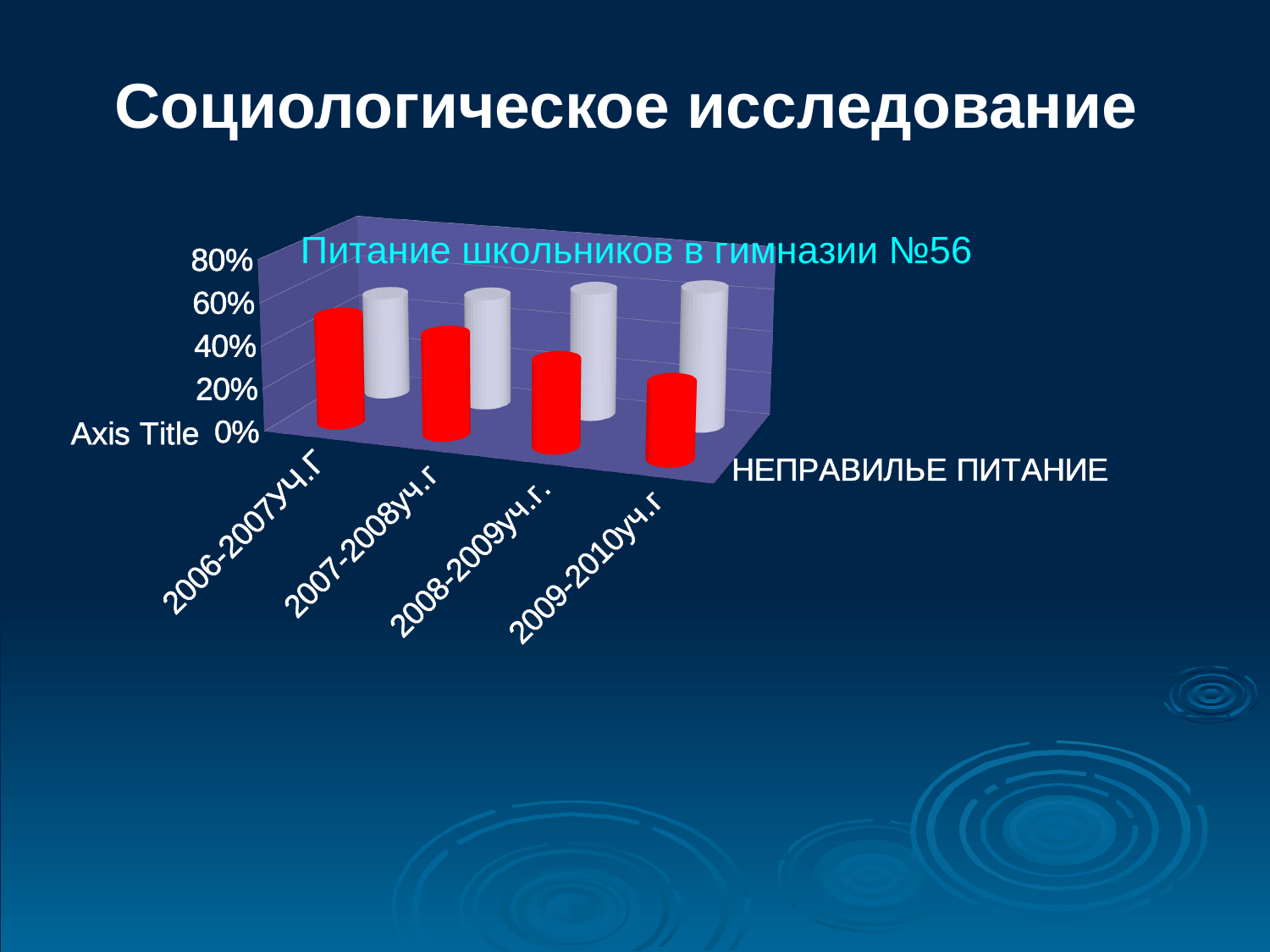
How many school-year categories are shown on the x axis of the chart? 4 Which school year has the lowest red bar? 2009-2010уч.г Which red bar is taller, 2007-2008уч.г or 2008-2009уч.г.? 2007-2008уч.г Is the red bar for 2006-2007уч.г greater or less than 40%? greater What is the title of the chart? Питание школьников в гимназии №56 What type of chart is shown on the slide? bar chart Which school year has the highest red bar? 2006-2007УЧ.Г Which red bar is taller, 2006-2007уч.г or 2009-2010уч.г? 2006-2007УЧ.Г Is the red bar for 2009-2010уч.г greater or less than 60%? less Do the red bars rise or fall from 2006-2007уч.г to 2009-2010уч.г? fall What is the highest percentage tick shown on the vertical axis? 80%